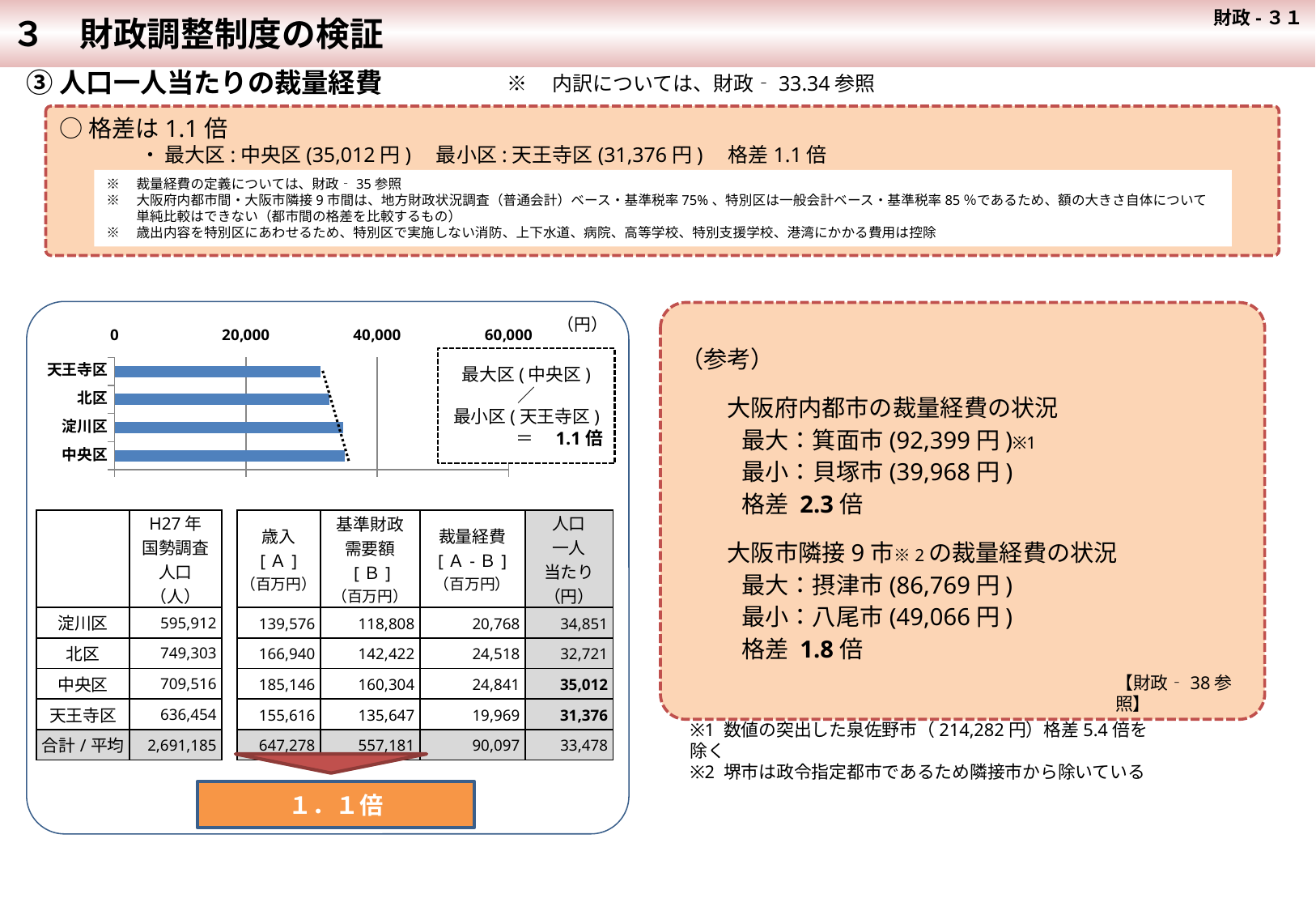
Which ward has the highest per-capita discretionary expense (人口一人当たり) in the chart? 中央区 What is the difference between the per-capita discretionary expense of 中央区 and 天王寺区? 3,636 What kind of chart is shown on the slide? bar chart What is the per-capita discretionary expense (人口一人当たり) for 淀川区? 34,851 What is the per-capita discretionary expense (人口一人当たり) for 天王寺区? 31,376 Which has the larger per-capita discretionary expense, 中央区 or 天王寺区? 中央区 Which ward has the lowest per-capita discretionary expense (人口一人当たり) in the chart? 天王寺区 Is the bar for 北区 greater or less than 40,000? less According to the box inside the chart, what is the ratio of the largest ward (中央区) to the smallest ward (天王寺区)? 1.1 倍 Is the bar for 天王寺区 greater or less than 20,000? greater How many wards (categories) are plotted in the bar chart? 4 What is the per-capita discretionary expense (人口一人当たり) for 中央区? 35,012